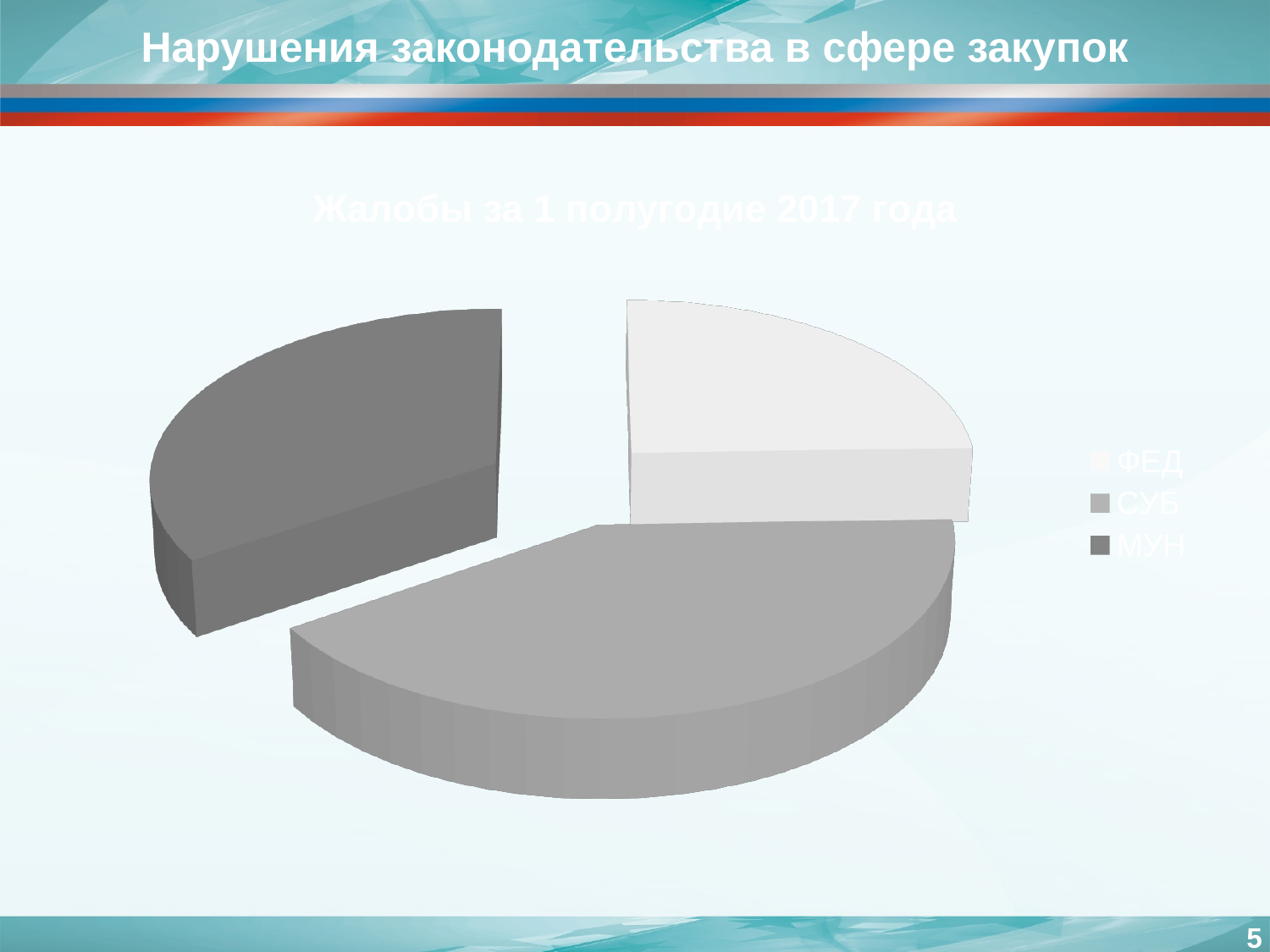
What kind of chart is shown on the slide? pie chart Which legend entries are listed for the pie chart? ФЕД, СУБ, МУН What is the title of the pie chart? Жалобы за 1 полугодие 2017 года Which slice is larger, СУБ or ФЕД? СУБ How many slices does the pie chart have? 3 Which category has the largest slice in the pie chart? СУБ How many entries does the legend of the pie chart list? 3 Which slice is larger, СУБ or МУН? СУБ